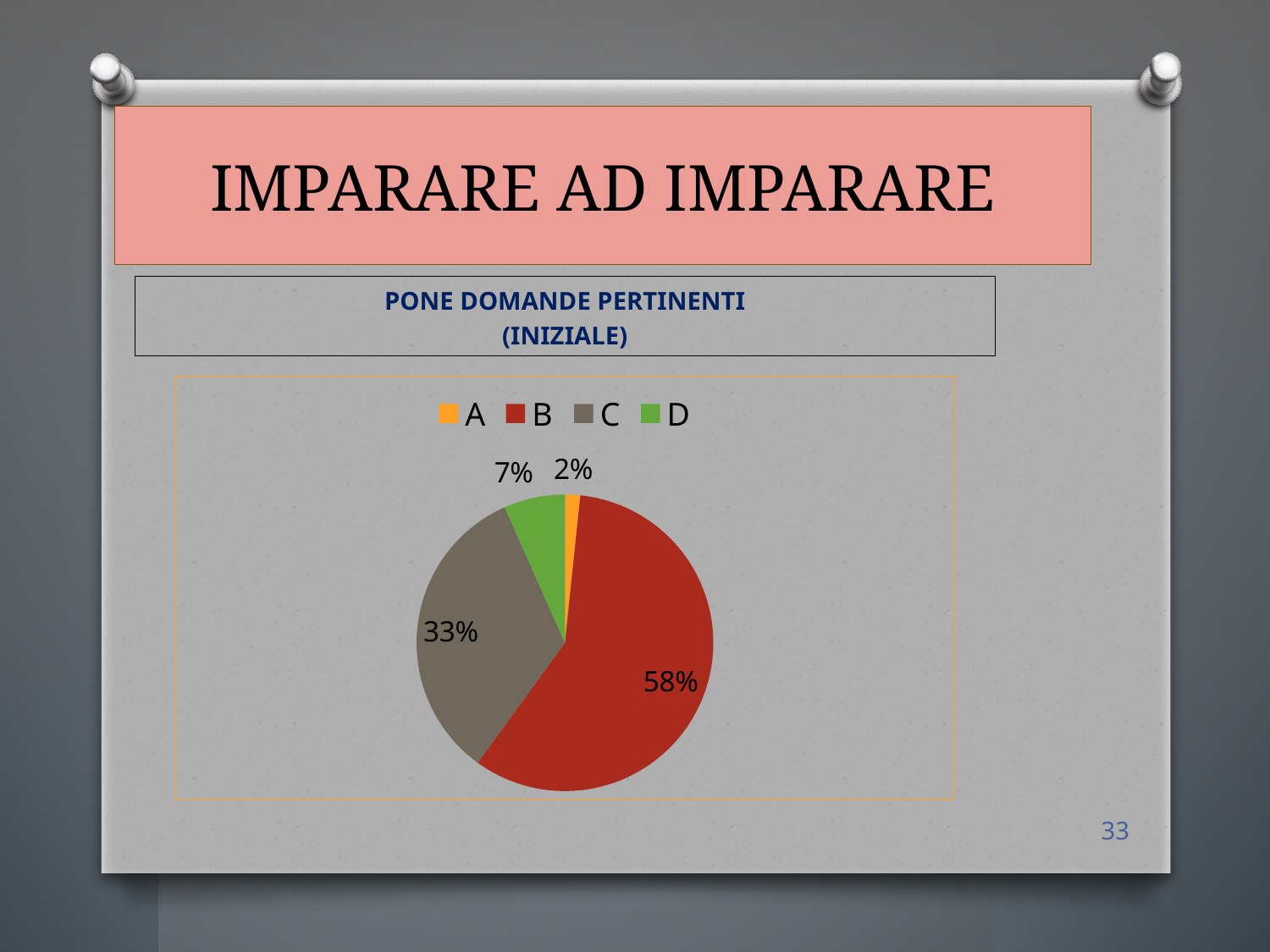
What share of the pie does category D have? 7% Which category has the largest slice of the pie? B What is the difference in percentage points between category B and category C? 25 Which category has the smallest slice of the pie? A What share of the pie does category C have? 33% What colour is the slice for category B? red What kind of chart is shown on the slide? pie chart Which is larger, the slice for C or the slice for D? C What share of the pie does category B have? 58% How many categories does the legend list? 4 What is the title shown above the chart? PONE DOMANDE PERTINENTI (INIZIALE)